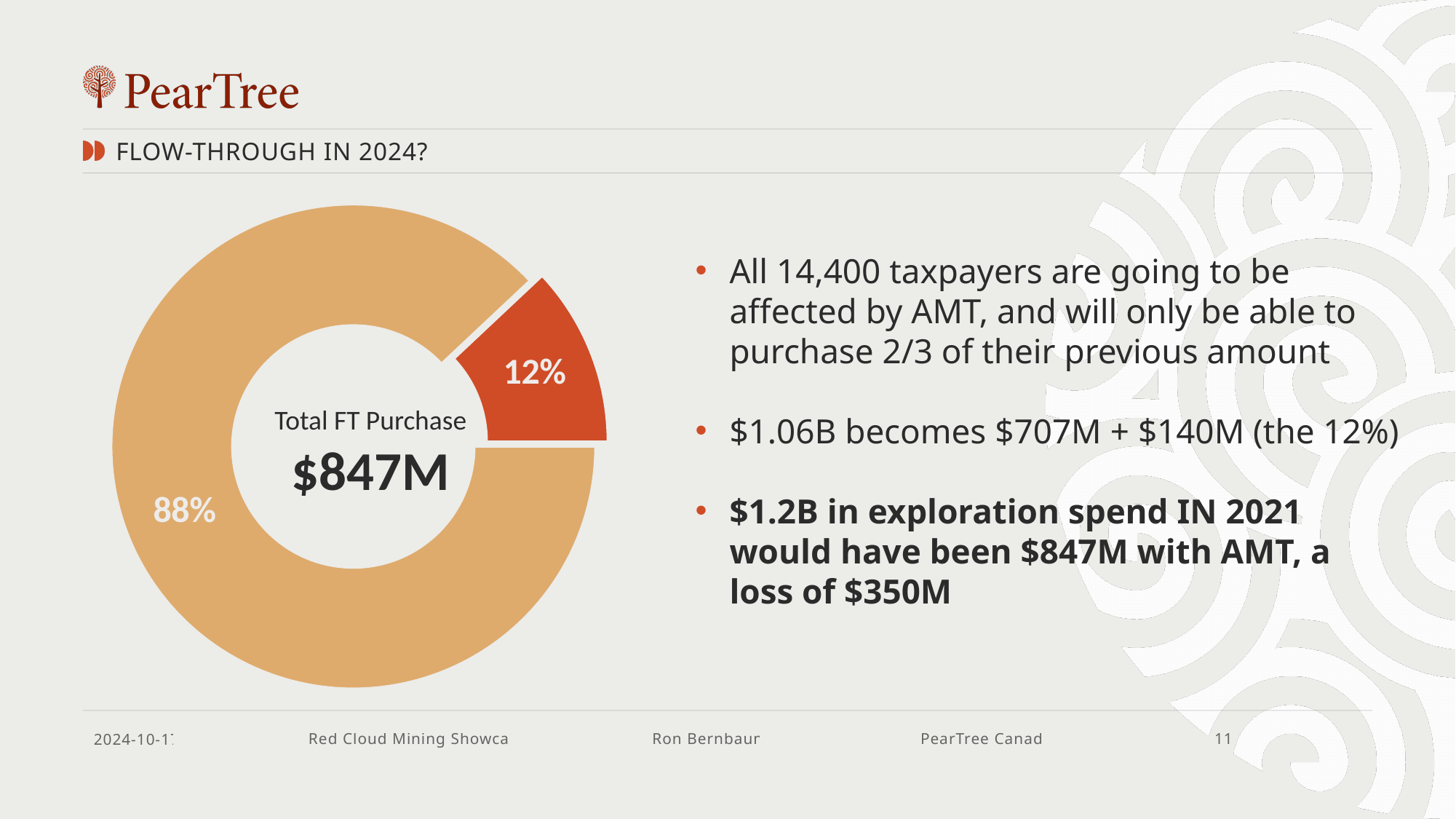
What total value is printed in the centre of the donut chart? $847M What kind of chart is shown on the slide? Donut (pie) chart What colour is the 12% slice of the donut chart? Red Which is larger in the donut chart, the red slice or the tan slice? The tan slice By how many percentage points does the tan slice exceed the red slice in the donut chart? 76 percentage points Which slice of the donut chart is the smallest? The red slice (12%) What label appears in the centre of the donut chart above the value? Total FT Purchase What share of the donut chart does the red slice represent? 12% What share of the donut chart does the tan (light orange) slice represent? 88% Which slice of the donut chart is the largest? The tan slice (88%) How many slices does the donut chart have? 2